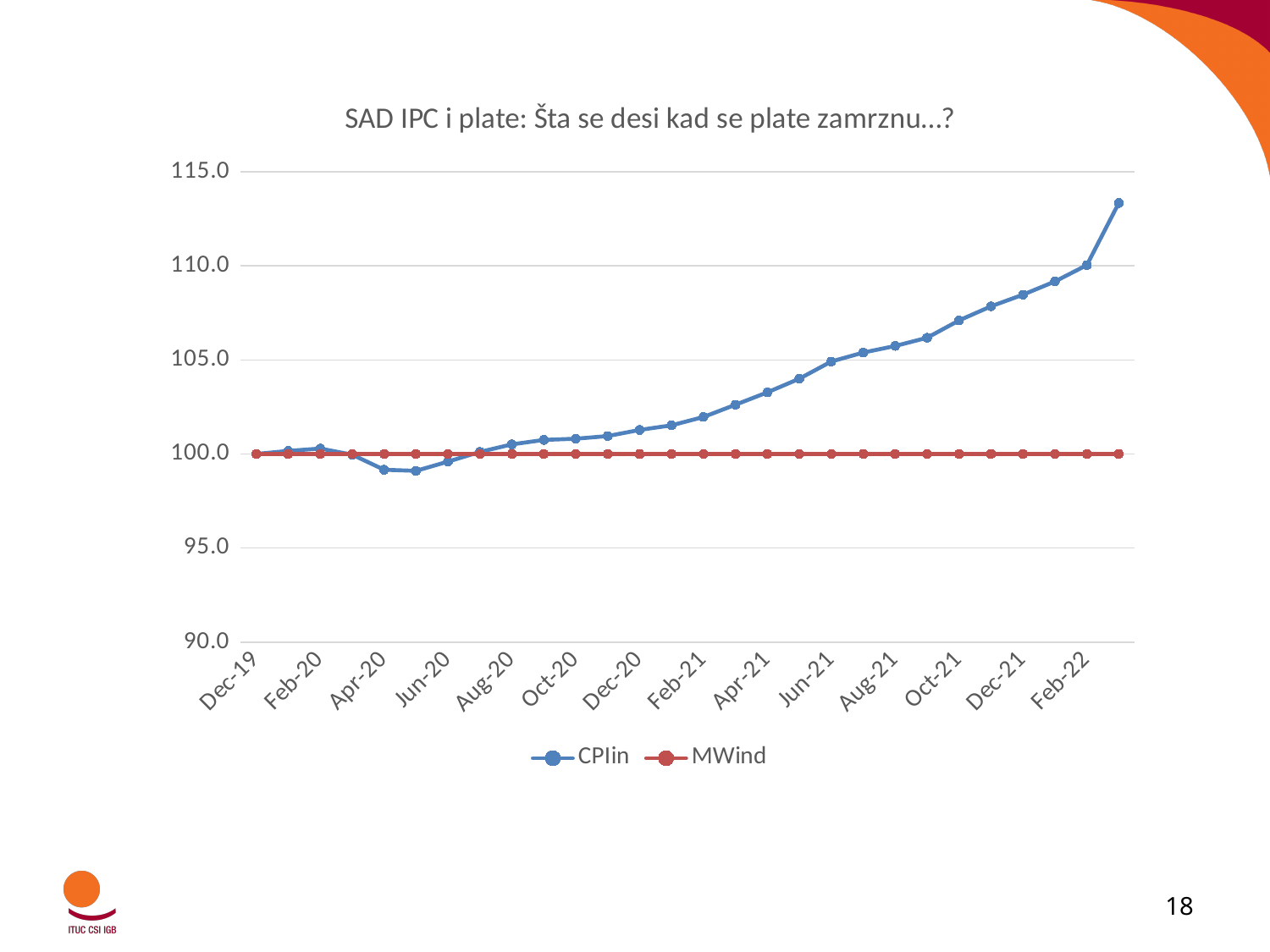
Does the MWind series rise, fall or stay flat across the x axis? stay flat Which series is drawn in red? MWind Is the value of CPIin at Apr-21 greater or less than 105.0? less Is the value of CPIin at Apr-20 greater or less than 100.0? less At Dec-21, which series has the higher value, CPIin or MWind? CPIin How many series does the legend list? 2 What is the value of MWind at Feb-22? 100.0 What is the title of the chart? SAD IPC i plate: Šta se desi kad se plate zamrznu…? Does the CPIin series generally rise or fall from Dec-19 to Feb-22? rise Is the value of CPIin at Dec-21 greater or less than 105.0? greater What is the value of MWind at Jun-21? 100.0 What kind of chart is shown on the slide? line chart